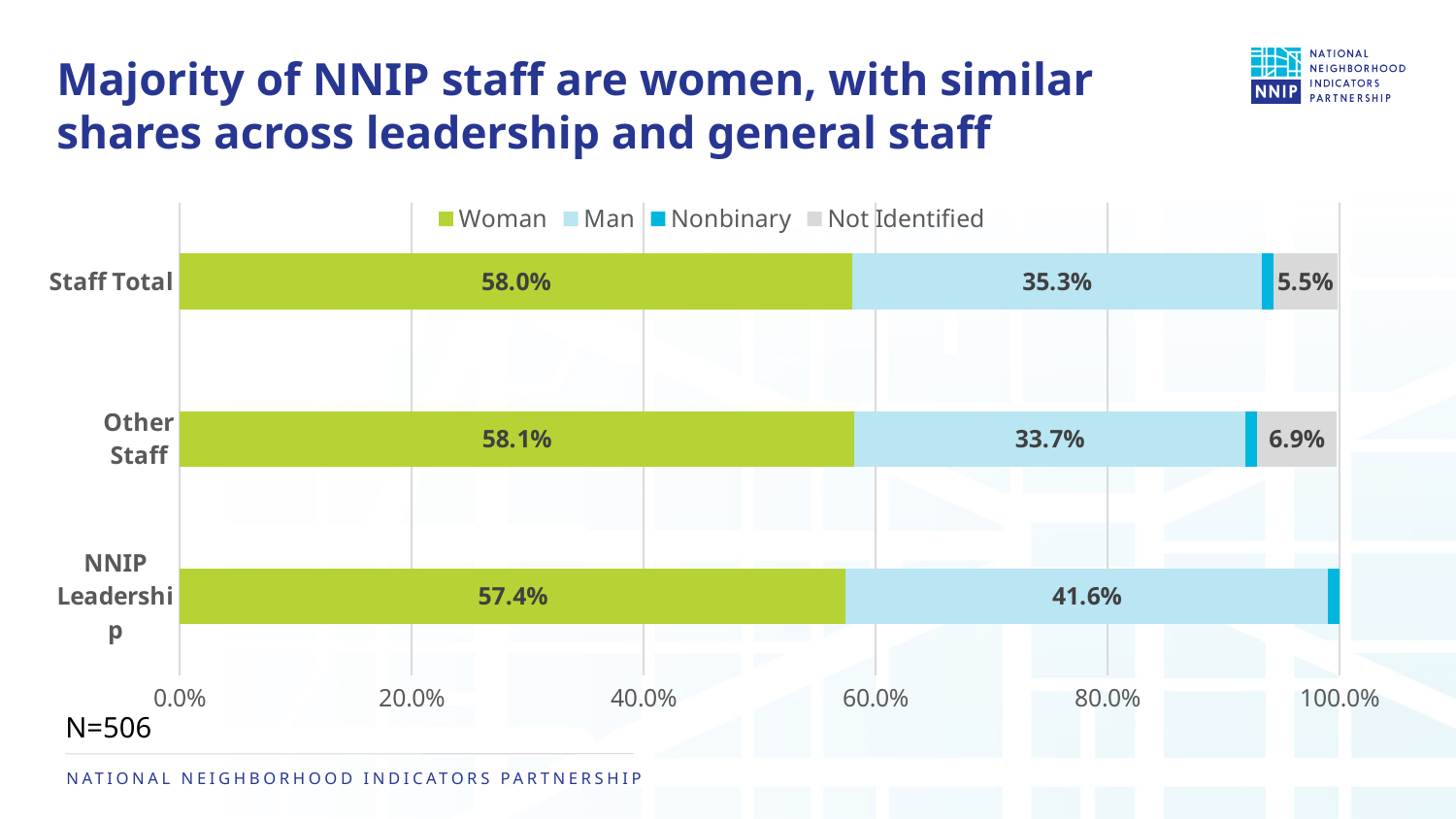
What kind of chart is shown on the slide? Stacked bar chart How many percentage points higher is the Man share for NNIP Leadership than for Other Staff? 7.9 percentage points Which category has the highest Man share? NNIP Leadership What is the Man share for NNIP Leadership? 41.6% How many categories are shown on the chart? 3 What is the difference between the Woman share and the Man share for Staff Total? 22.7 percentage points Which category has the lowest Woman share? NNIP Leadership What is the Man share for Other Staff? 33.7% What is the Not Identified share for Other Staff? 6.9% How many series does the legend list? 4 What percentage of Staff Total are women? 58.0% Is the Not Identified share larger for Other Staff or for Staff Total? Other Staff